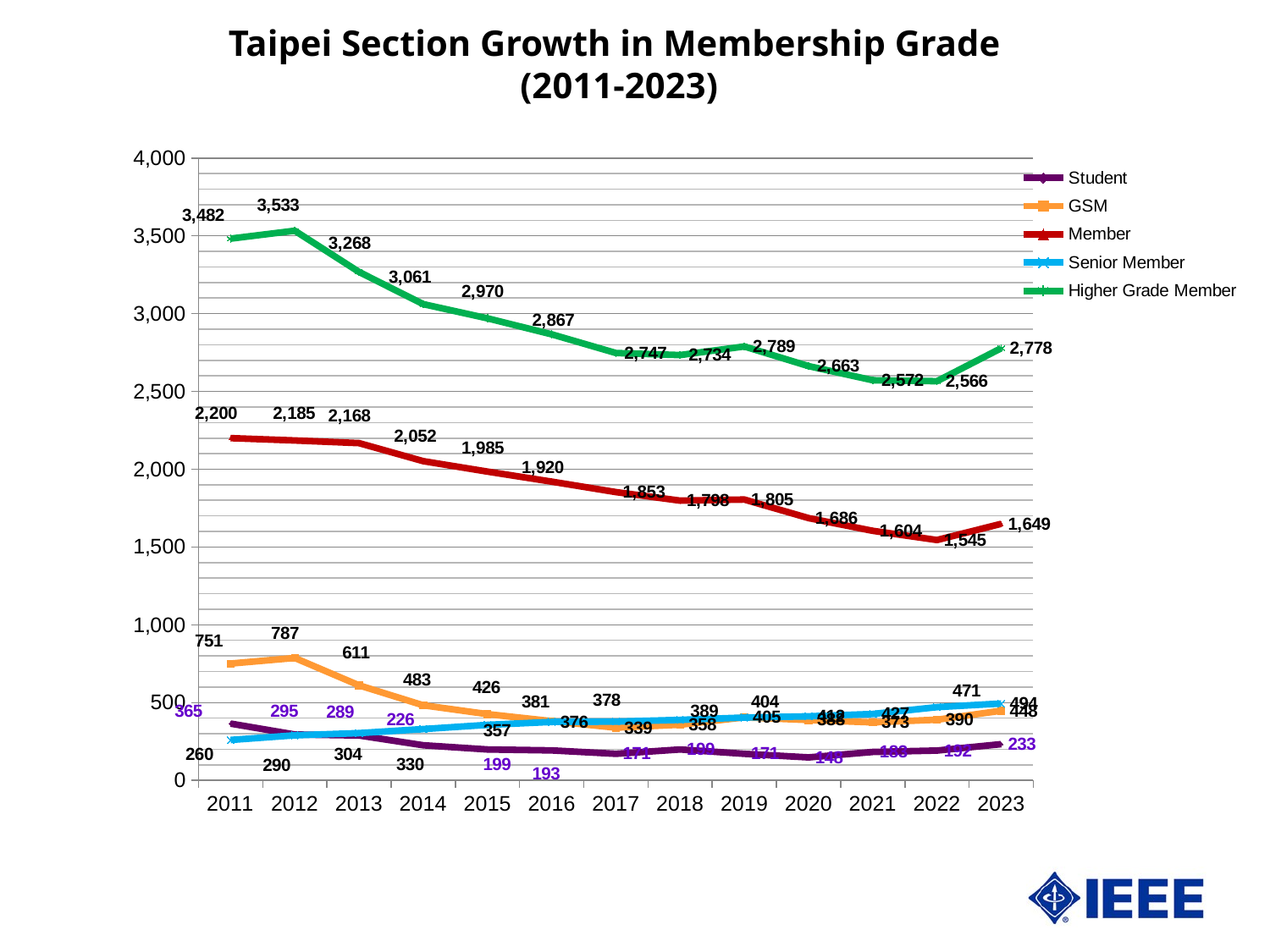
In which year was the Member count lowest? 2022 How many years are plotted along the x axis? 13 How many series does the legend list? 5 What was the GSM count in 2012? 787 What was the Higher Grade Member count in 2011? 3,482 In which year was the Higher Grade Member count highest? 2012 What was the Senior Member count in 2023? 494 Does the Member line rise or fall from 2011 to 2016? fall Which year had the larger Student count, 2011 or 2023? 2011 What is the difference between the Higher Grade Member counts in 2012 and 2013? 265 What kind of chart is shown on the slide? line chart By how much did the Member count fall from 2011 to 2023? 551